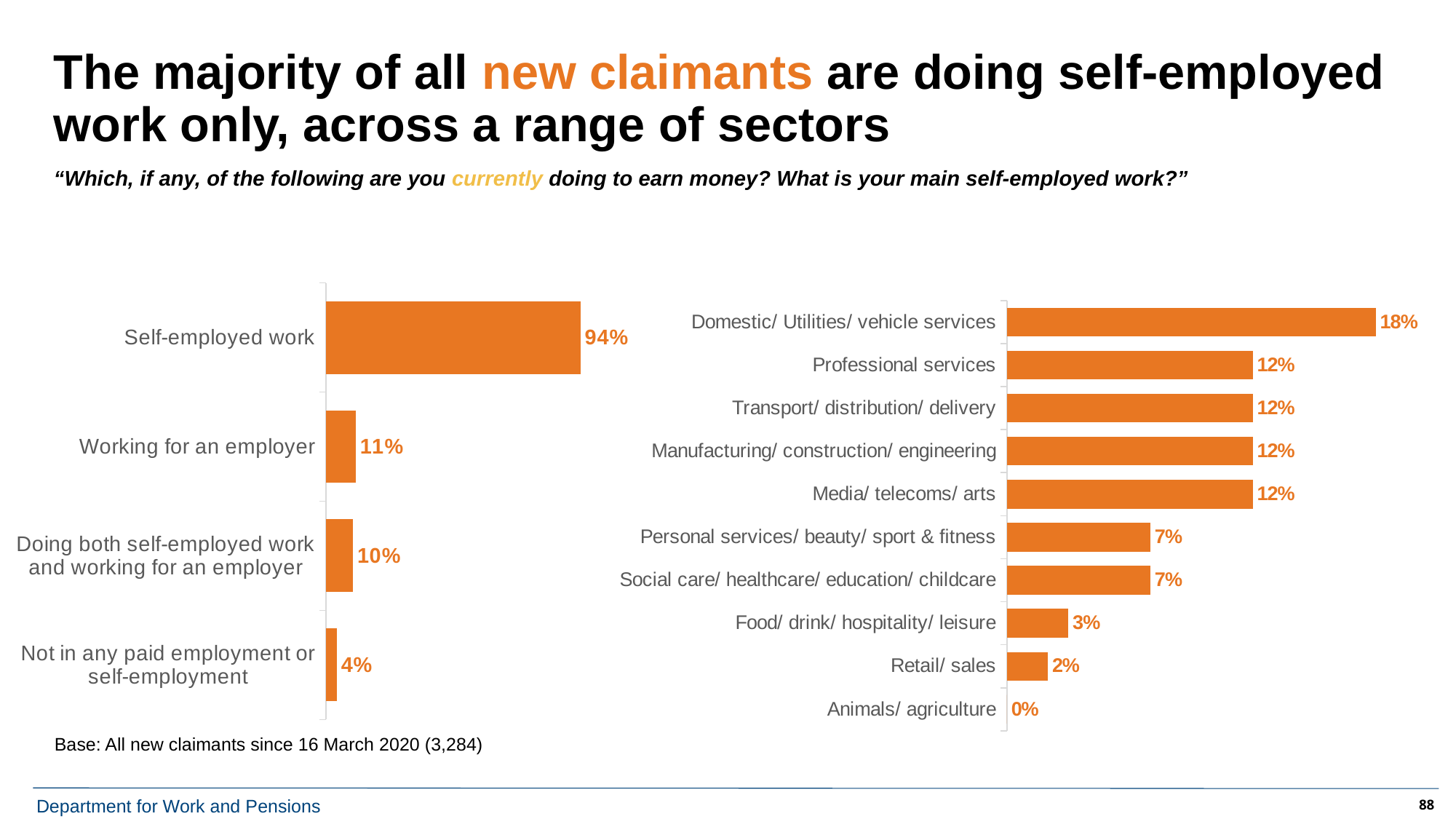
In the right chart, which sector has the lowest value? Animals/ agriculture In the right chart, which is larger: 'Retail/ sales' or 'Personal services/ beauty/ sport & fitness'? Personal services/ beauty/ sport & fitness In the left chart, which category has the lowest value? Not in any paid employment or self-employment In the right chart, how many sectors are listed? 10 In the left chart, what percentage of new claimants are doing self-employed work? 94% In the right chart, which sector has the highest value? Domestic/ Utilities/ vehicle services In the left chart, what is the difference between 'Self-employed work' and 'Working for an employer'? 83% In the right chart, what is the value for 'Food/ drink/ hospitality/ leisure'? 3% What type of chart is used on the right side of the slide? Bar chart In the right chart, what is the value for 'Domestic/ Utilities/ vehicle services'? 18% In the left chart, what is the value for 'Working for an employer'? 11% In the left chart, how many categories are shown? 4